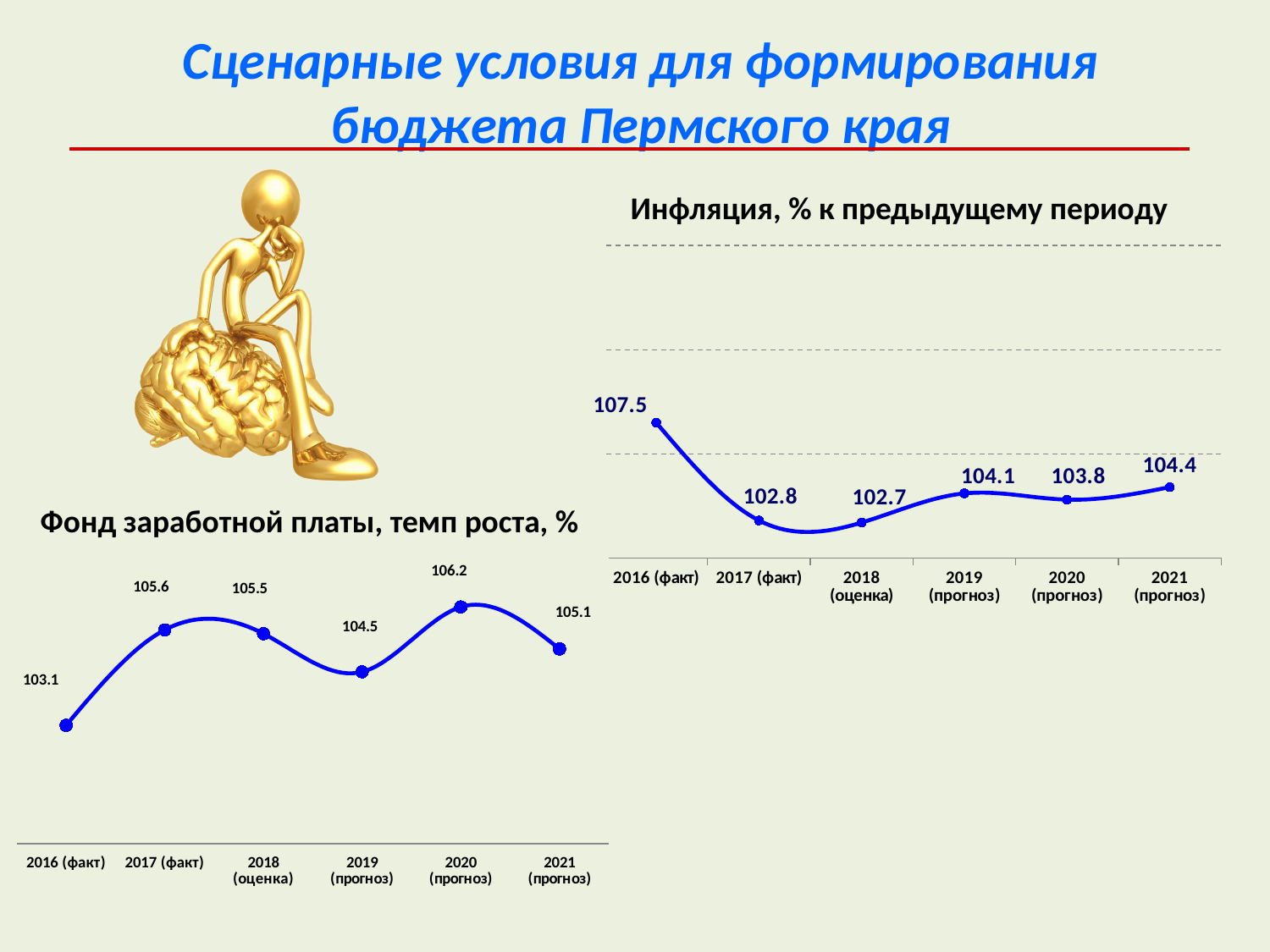
In the chart 'Фонд заработной платы, темп роста, %', which period has the highest value? 2020 (прогноз) In the chart 'Инфляция, % к предыдущему периоду', which period has the lowest value? 2018 (оценка) In the chart 'Фонд заработной платы, темп роста, %', what is the value for 2020 (прогноз)? 106.2 In the chart 'Фонд заработной платы, темп роста, %', which is larger: the value for 2017 (факт) or 2019 (прогноз)? 2017 (факт) In the chart 'Инфляция, % к предыдущему периоду', what is the value for 2019 (прогноз)? 104.1 In the chart 'Фонд заработной платы, темп роста, %', what is the difference between the values for 2020 (прогноз) and 2021 (прогноз)? 1.1 What type of chart is the chart 'Инфляция, % к предыдущему периоду'? Line chart In the chart 'Фонд заработной платы, темп роста, %', what is the value for 2016 (факт)? 103.1 In the chart 'Инфляция, % к предыдущему периоду', what is the value for 2016 (факт)? 107.5 In the chart 'Инфляция, % к предыдущему периоду', what is the difference between the values for 2016 (факт) and 2017 (факт)? 4.7 In the chart 'Фонд заработной платы, темп роста, %', which period has the lowest value? 2016 (факт) In the chart 'Инфляция, % к предыдущему периоду', how many data points are plotted? 6